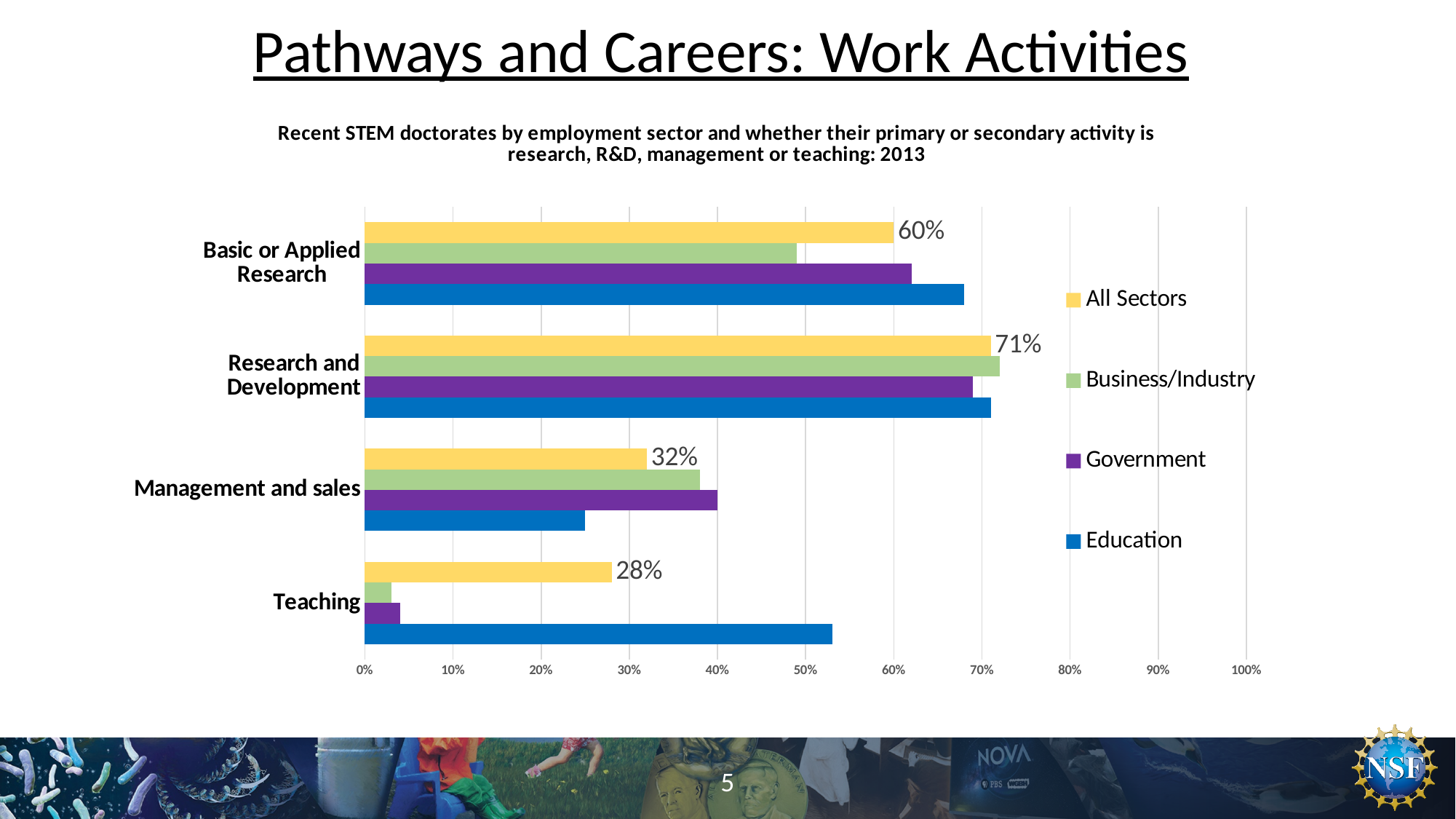
What is the All Sectors value for Teaching? 28% How many series does the legend list? 4 How many work activity categories are shown on the chart? 4 Is the Business/Industry value for Teaching greater or less than 10%? less What is the difference between the All Sectors values for Research and Development and Basic or Applied Research? 11 percentage points Is the Education value for Teaching greater or less than 50%? greater For Management and sales, which is larger: the Government value or the Education value? Government What is the All Sectors value for Basic or Applied Research? 60% Which activity has the lowest All Sectors value? Teaching What kind of chart is shown on the slide? Bar chart Which activity has the highest All Sectors value? Research and Development What is the All Sectors value for Research and Development? 71%